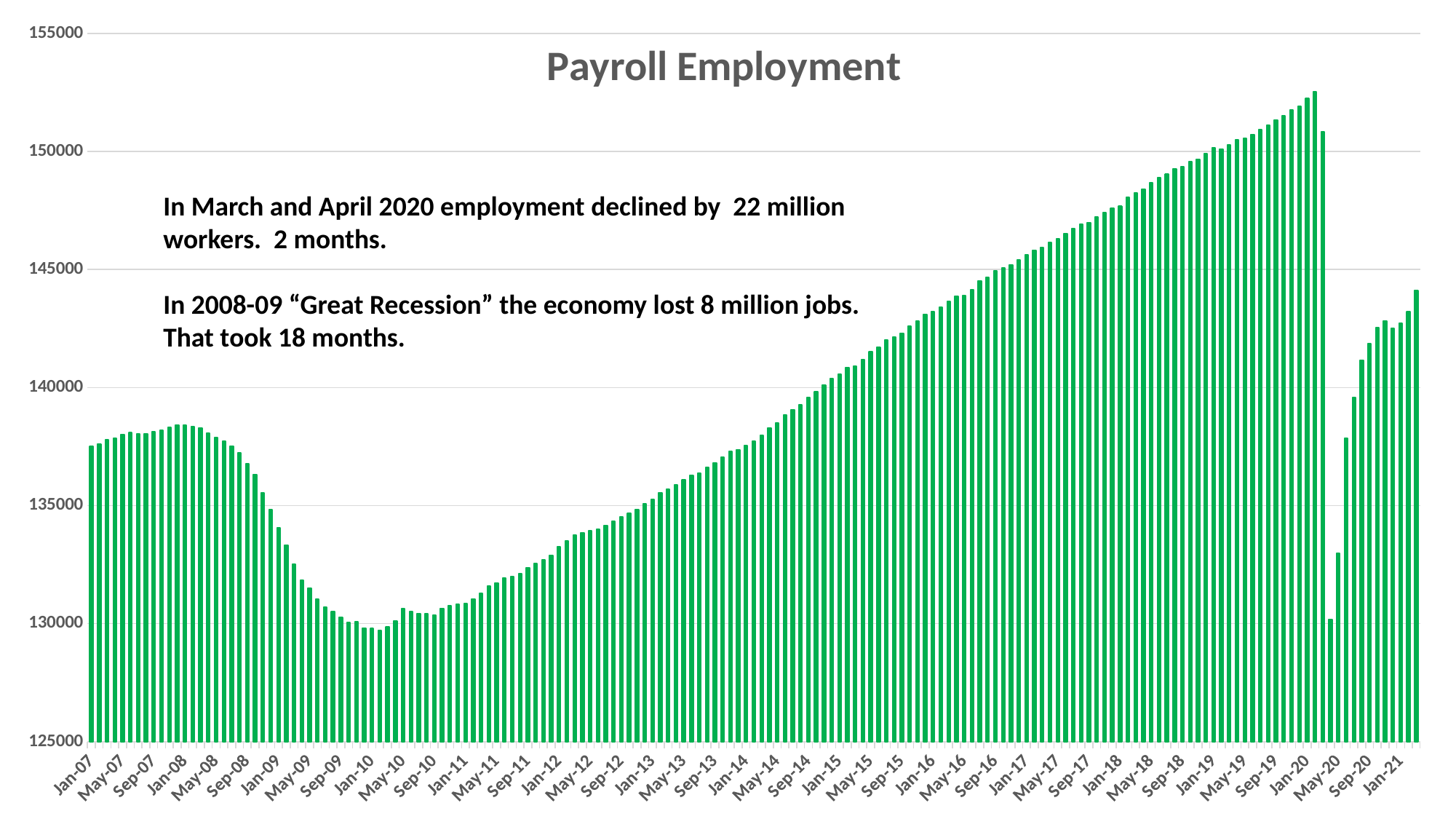
Do the values rise or fall from Jan-10 to Jan-20? rise Is the value for Jan-07 greater or less than 135000? greater What kind of chart is shown on the slide? bar chart Which is larger, the value for Jan-20 or the value for Jan-21? Jan-20 Is the value for Jan-10 greater or less than 135000? less Which is larger, the value for Jan-07 or the value for Jan-10? Jan-07 Is the value for Jan-21 greater or less than 140000? greater What is the title of the chart? Payroll Employment What colour are the bars in the chart? green